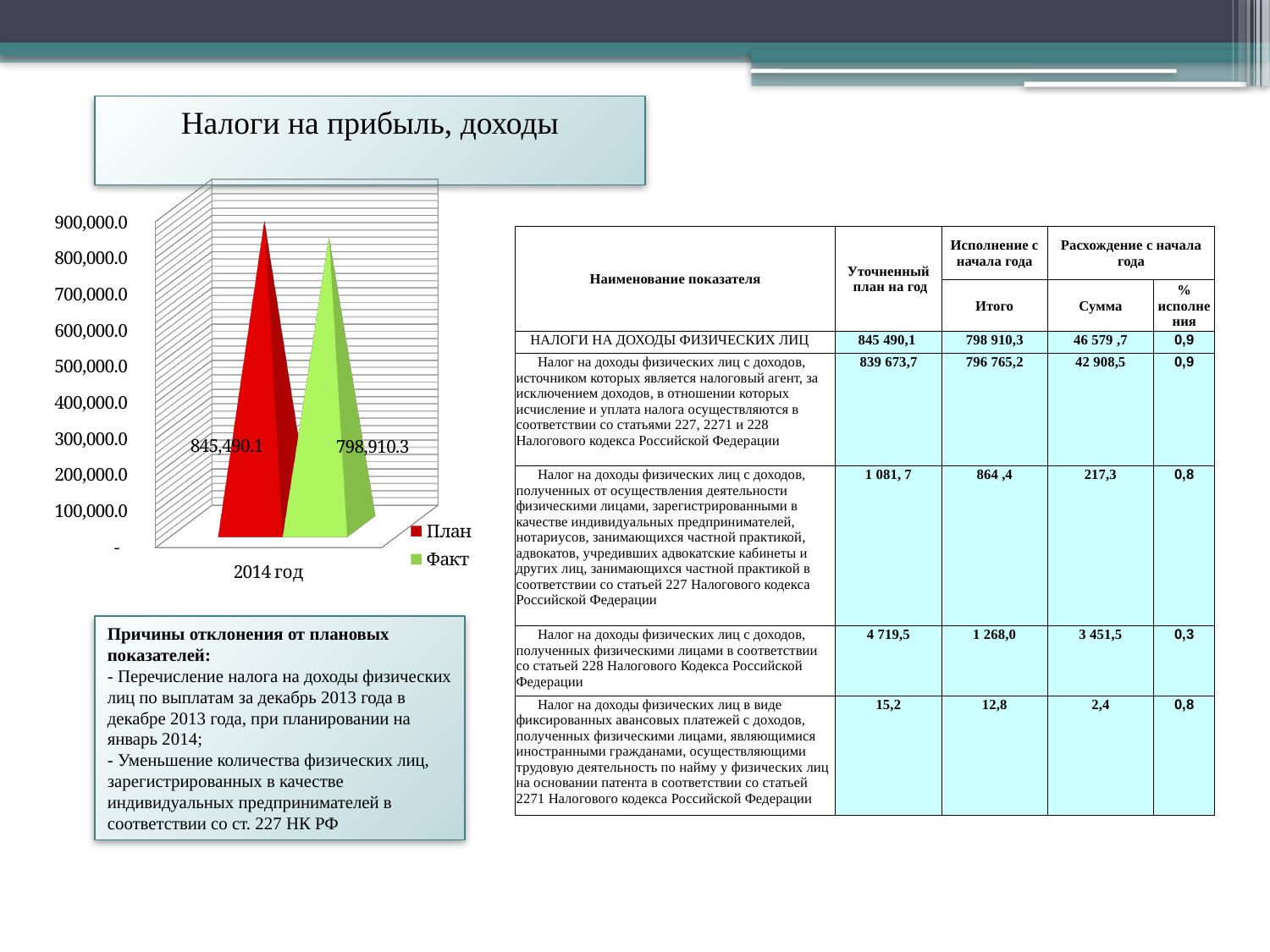
How many categories are shown on the x axis of the chart? 1 What is the value of the План series in the chart? 845,490.1 Which series has the higher value in the chart, План or Факт? План Is the value for План greater or less than 800,000.0? greater Which series shows the lowest value in the chart? Факт What is the difference between the План and Факт values in the chart? 46,579.8 Is the value for Факт greater or less than 800,000.0? less What category label is shown on the x axis of the chart? 2014 год How many series does the chart legend list? 2 What colour represents the План series in the chart? red What kind of chart is shown on the slide? bar chart What is the value of the Факт series in the chart? 798,910.3